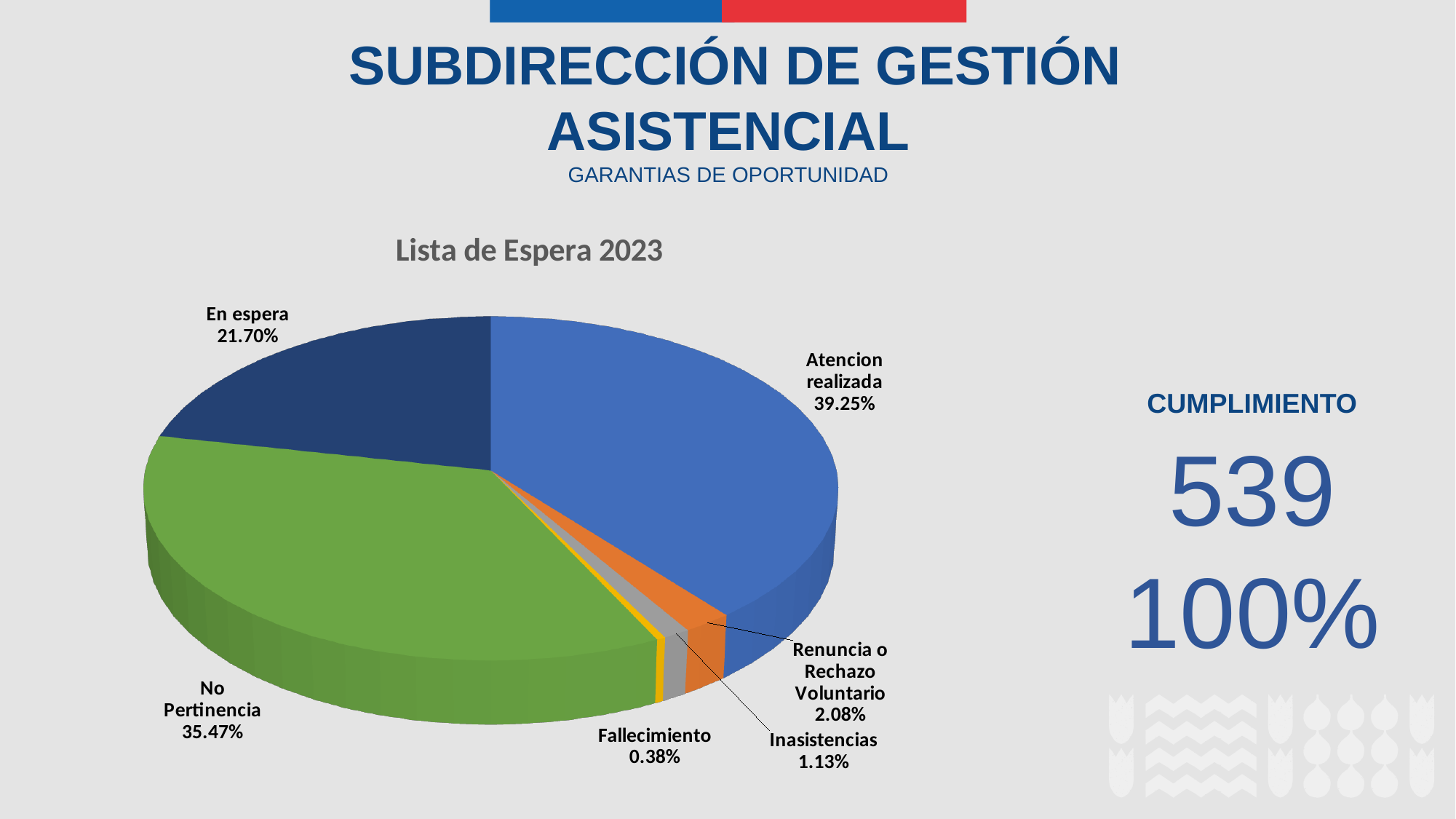
Which is larger, the share for No Pertinencia or the share for En espera? No Pertinencia How many categories (slices) does the pie chart have? 6 What percentage of the pie is labelled Atencion realizada? 39.25% What type of chart is shown on the slide? Pie chart What percentage of the pie is labelled En espera? 21.70% What percentage of the pie is labelled Inasistencias? 1.13% What is the title of the chart? Lista de Espera 2023 Which category has the largest share of the pie? Atencion realizada What percentage of the pie is labelled Fallecimiento? 0.38% What is the difference in percentage points between Atencion realizada and No Pertinencia? 3.78 What percentage of the pie is labelled No Pertinencia? 35.47% Which category has the smallest share of the pie? Fallecimiento